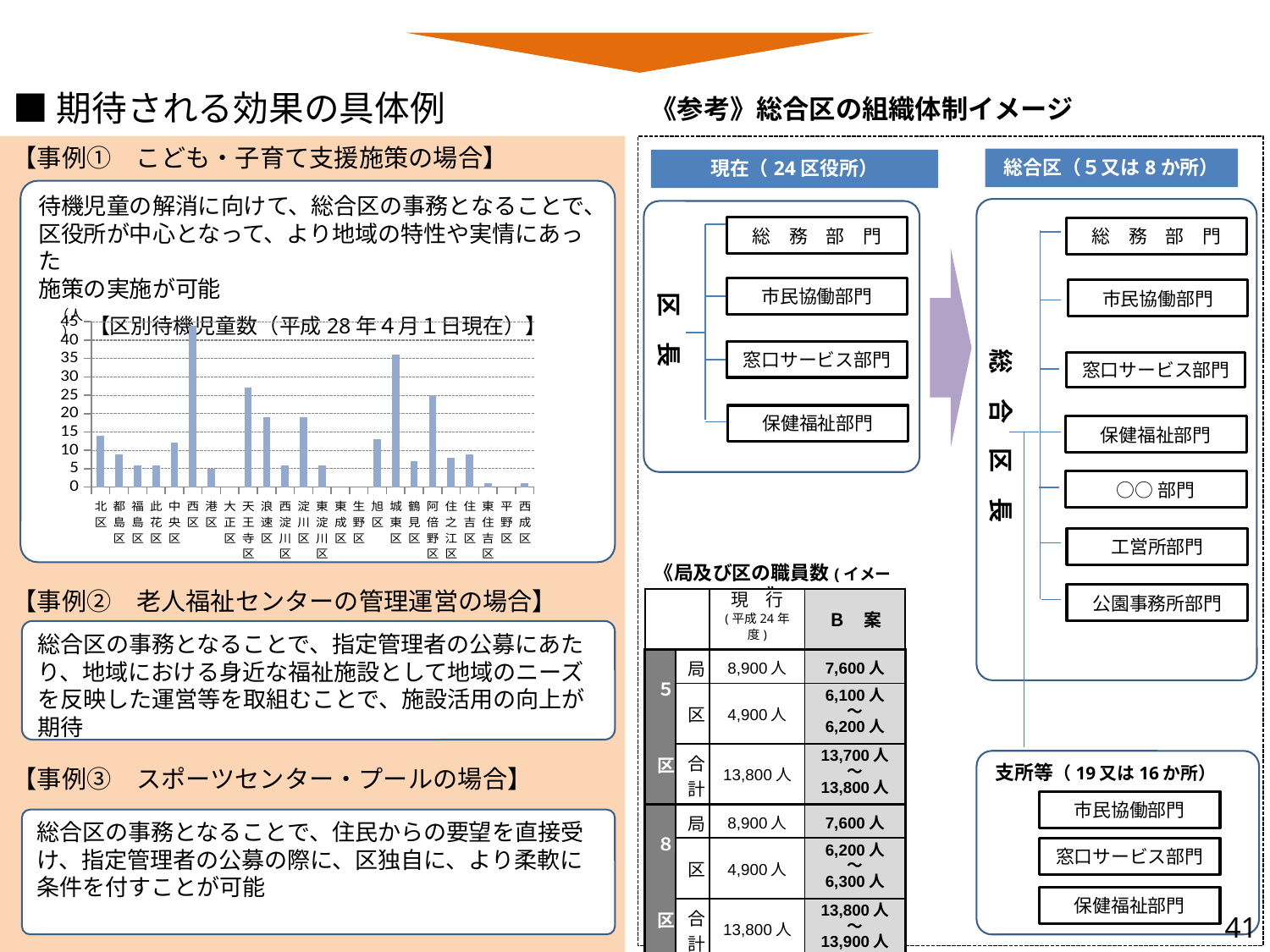
In the 区別待機児童数 chart, is the value for 天王寺区 greater or less than 20? greater Which ward has the highest number of waiting children in the 区別待機児童数 chart? 西区 In the 区別待機児童数 chart, which ward has the larger value, 西区 or 城東区? 西区 In the 区別待機児童数 chart, is the value for 西区 greater or less than 40? greater How many wards (categories) are shown on the x axis of the 区別待機児童数 chart? 24 In the 区別待機児童数 chart, is the value for 港区 greater or less than 10? less In the 区別待機児童数 chart, which ward has the larger value, 浪速区 or 北区? 浪速区 What is the highest tick value shown on the y axis of the 区別待機児童数 chart? 45 What is the title of the bar chart on the slide? 【区別待機児童数（平成28年4月1日現在）】 What kind of chart is the 【区別待機児童数（平成28年4月1日現在）】 chart? bar chart